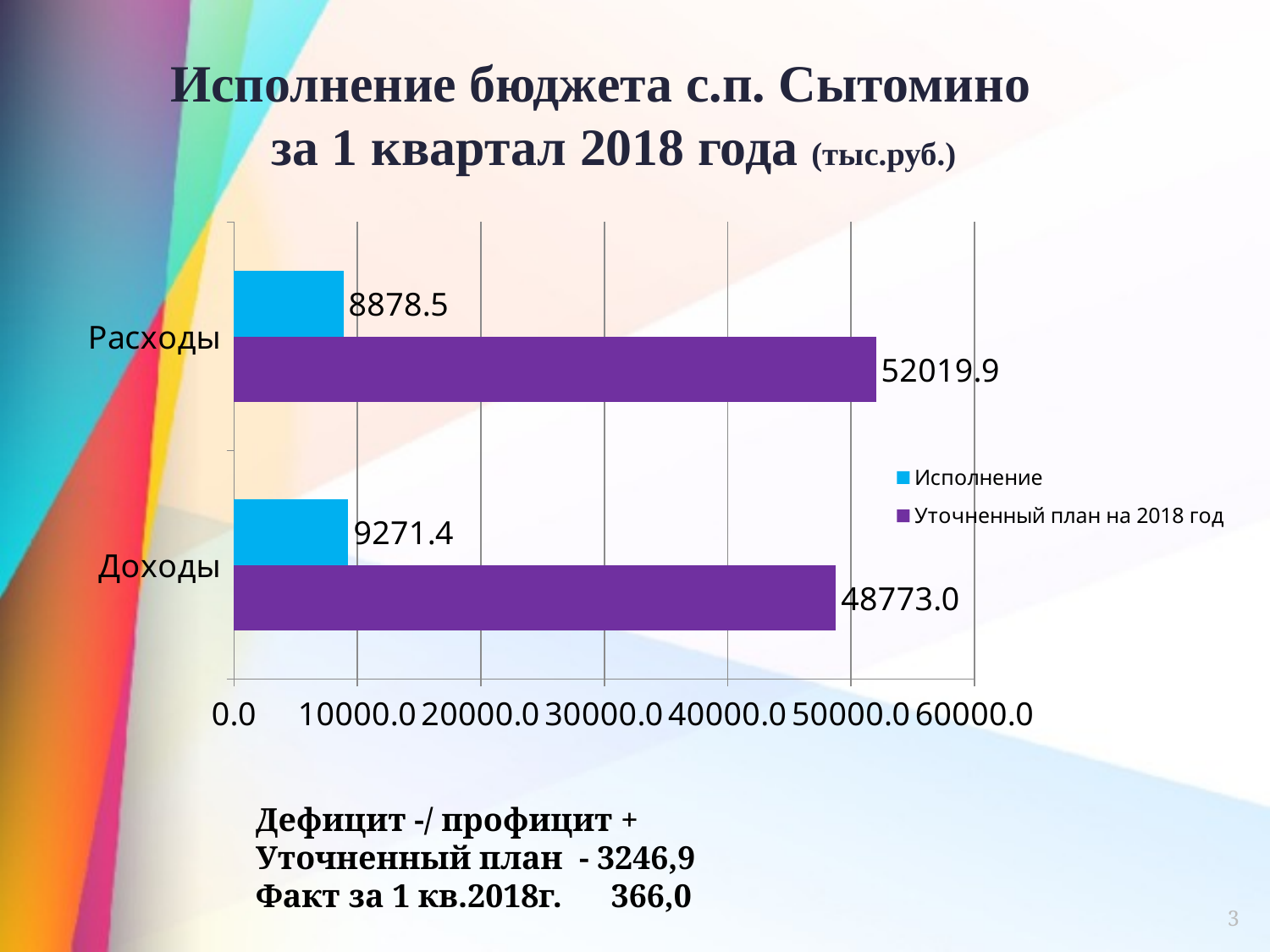
How many series does the legend list? 2 What is the value of Уточненный план на 2018 год for Расходы? 52019.9 What is the value of Исполнение for Расходы? 8878.5 Which category has the higher value for Уточненный план на 2018 год? Расходы What is the difference between Исполнение for Доходы and for Расходы? 392.9 Which category has the lower value for Исполнение? Расходы What is the value of Уточненный план на 2018 год for Доходы? 48773.0 How many categories are shown on the chart? 2 What is the value of Исполнение for Доходы? 9271.4 What kind of chart is shown on the slide? Bar chart What is the difference between Уточненный план на 2018 год for Расходы and for Доходы? 3246.9 Which is larger for Доходы: Исполнение or Уточненный план на 2018 год? Уточненный план на 2018 год